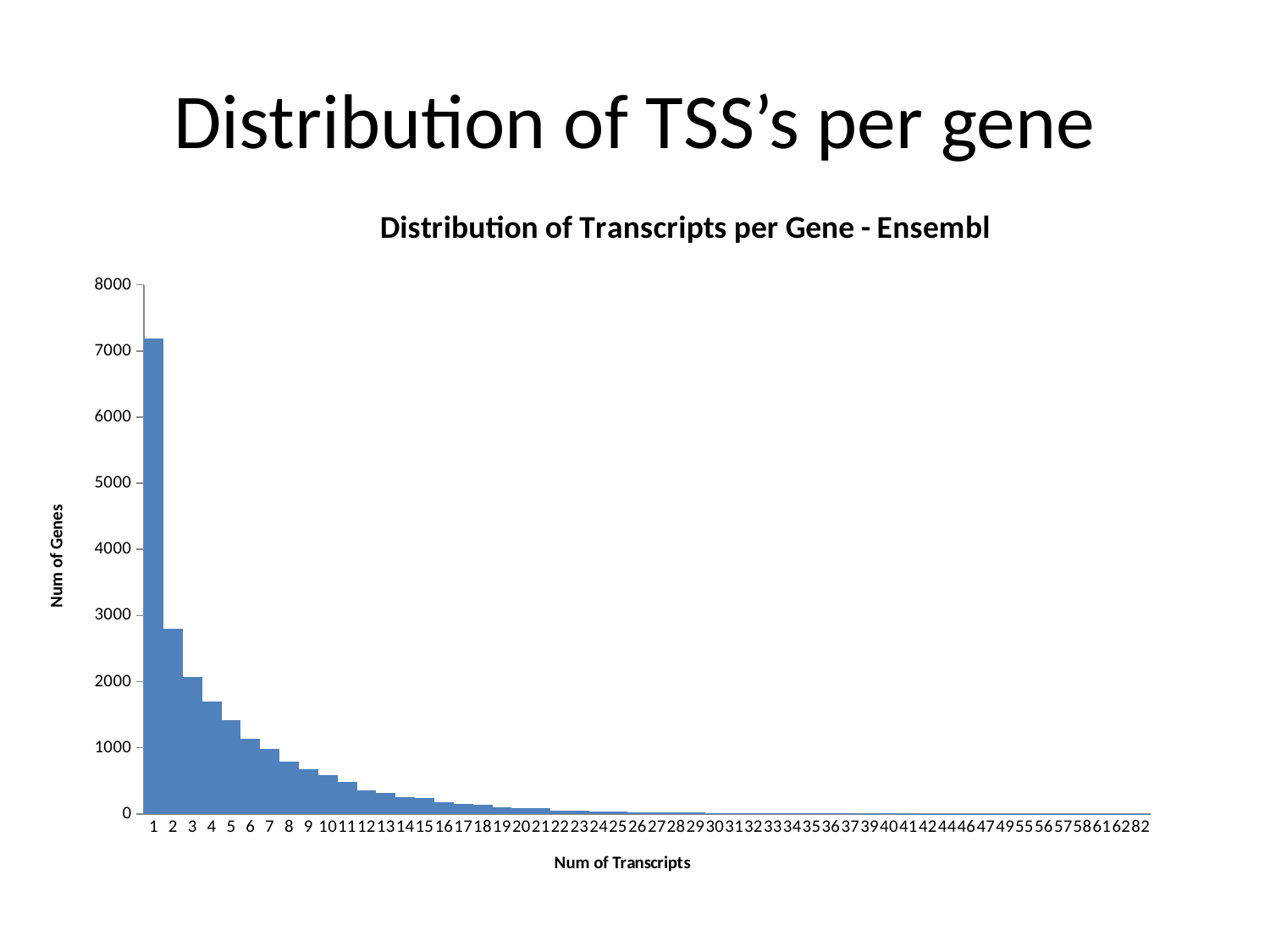
What kind of chart is shown on the slide? bar chart Which has more genes, 1 transcript or 2 transcripts? 1 Which has more genes, 3 transcripts or 5 transcripts? 3 What is the title of the chart? Distribution of Transcripts per Gene - Ensembl What is the label of the vertical axis? Num of Genes Is the value for 5 transcripts greater or less than 1000? greater Do the values rise or fall as the number of transcripts increases along the x axis? fall Is the value for 4 transcripts greater or less than 2000? less Is the value for 8 transcripts greater or less than 1000? less Which number of transcripts has the highest number of genes? 1